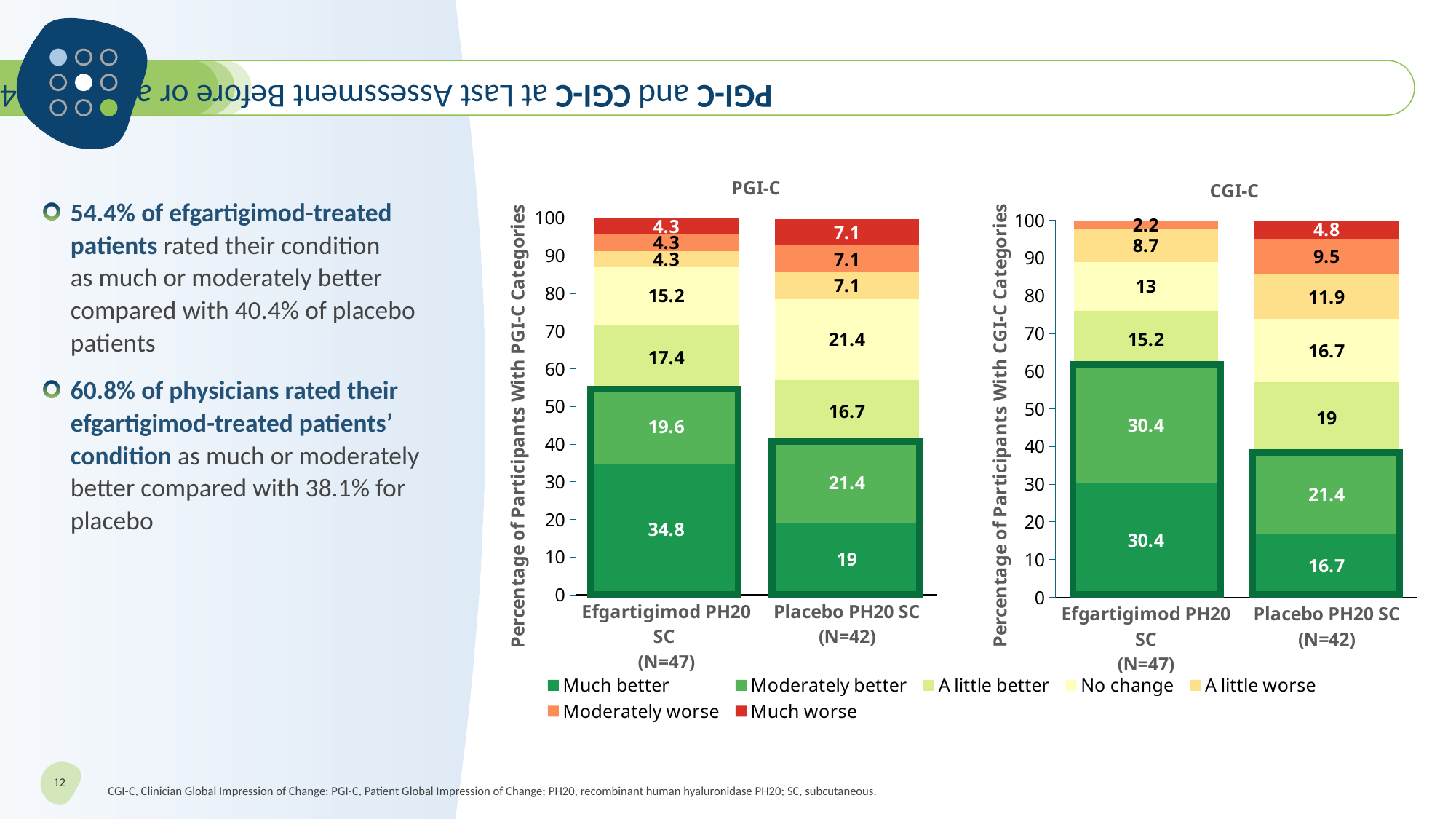
In the CGI-C chart, which group has the larger 'Much better' value, Efgartigimod PH20 SC or Placebo PH20 SC? Efgartigimod PH20 SC In the PGI-C chart, what is the difference between the 'Much better' values for Efgartigimod PH20 SC and Placebo PH20 SC? 15.8 In the PGI-C chart, what is the 'Moderately better' value for Placebo PH20 SC (N=42)? 21.4 How many series does the legend list for the charts? 7 What kind of chart is the PGI-C chart? Stacked bar chart What is the y-axis label of the CGI-C chart? Percentage of Participants With CGI-C Categories In the PGI-C chart, which group has the larger 'No change' value, Efgartigimod PH20 SC or Placebo PH20 SC? Placebo PH20 SC In the PGI-C chart, what percentage of Efgartigimod PH20 SC (N=47) participants rated 'Much better'? 34.8 In the CGI-C chart, what is the 'Much worse' value for Placebo PH20 SC (N=42)? 4.8 In the CGI-C chart, what is the difference between the 'A little worse' values for Placebo PH20 SC and Efgartigimod PH20 SC? 3.2 How many treatment groups are shown on the x axis of the CGI-C chart? 2 In the CGI-C chart, what is the 'No change' value for Efgartigimod PH20 SC (N=47)? 13